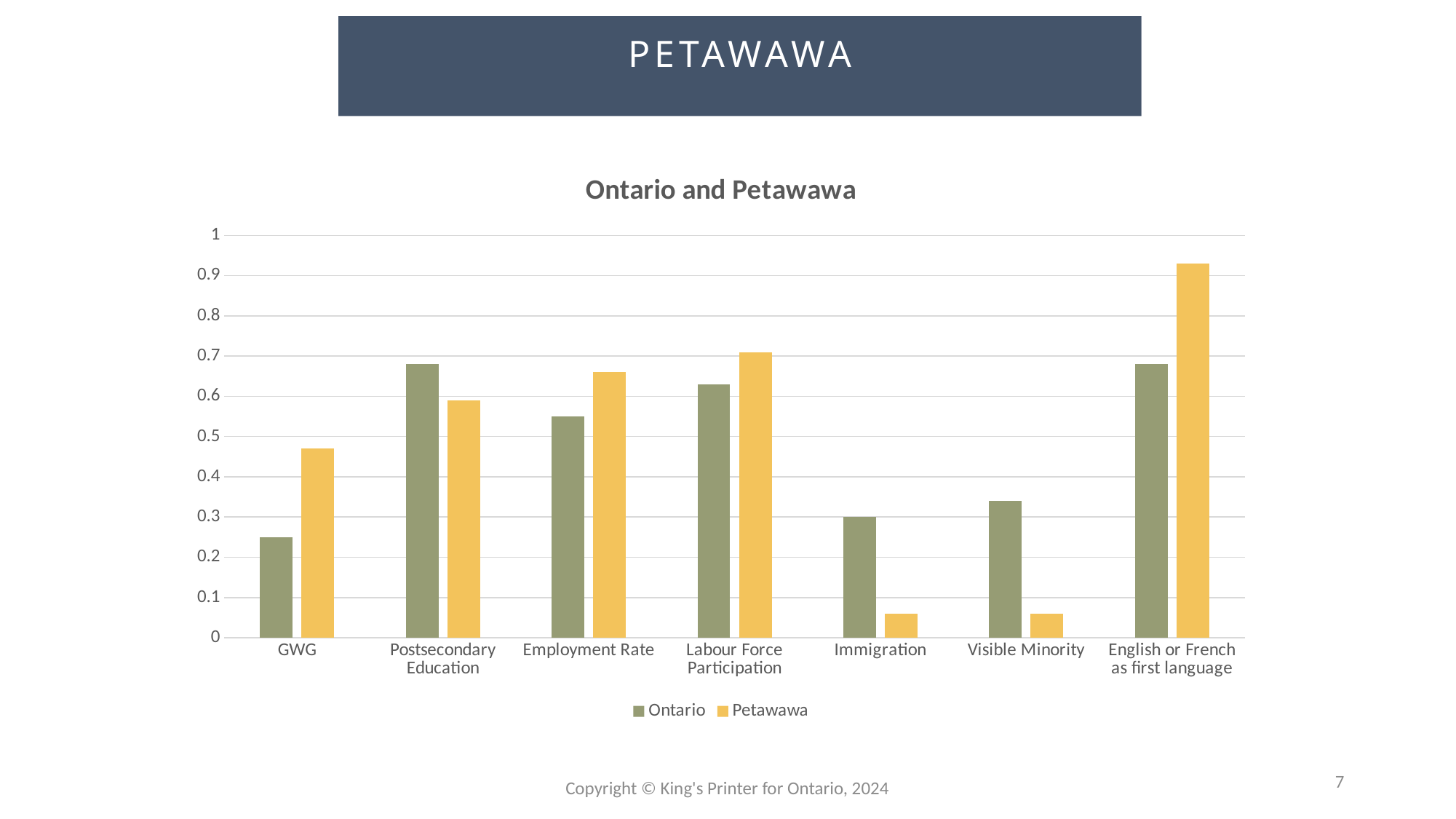
What kind of chart is shown on the slide? bar chart Which category has the lowest Ontario value? GWG Which category has the highest Petawawa value? English or French as first language How many categories are shown on the x axis? 7 How many series does the legend list? 2 For GWG, which is larger, the Ontario value or the Petawawa value? Petawawa Is the Petawawa value for Immigration greater or less than 0.1? less For Visible Minority, which is larger, the Ontario value or the Petawawa value? Ontario What is the title of the chart? Ontario and Petawawa Is the Petawawa value for English or French as first language greater or less than 0.9? greater Is the Ontario value for GWG greater or less than 0.3? less